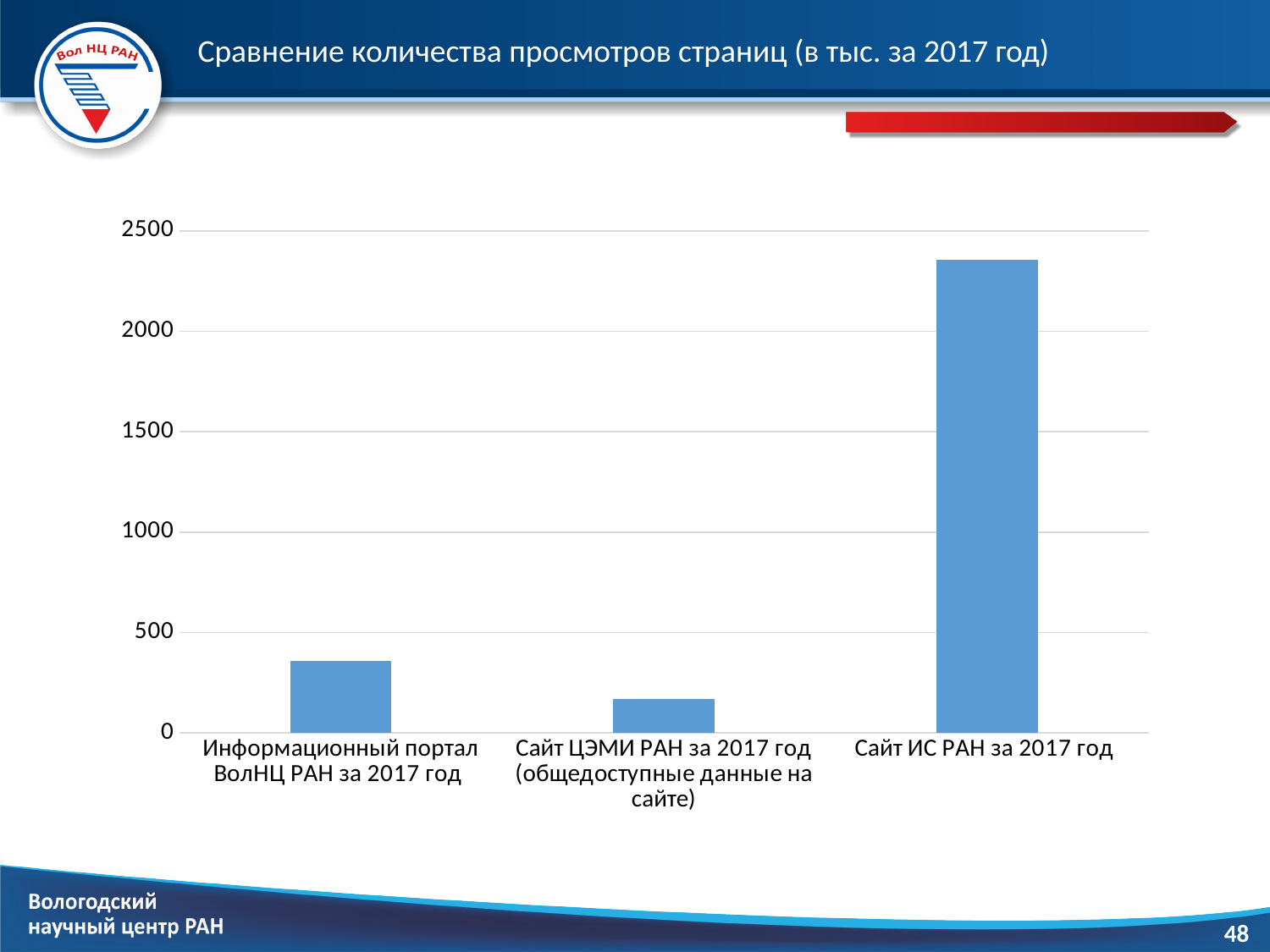
Is the value for Сайт ИС РАН за 2017 год greater or less than 2500? less Is the value for Сайт ИС РАН за 2017 год greater or less than 2000? greater Which category has the highest number of page views? Сайт ИС РАН за 2017 год How many bars (categories) does the chart show? 3 What kind of chart is shown on the slide? bar chart Is the value for Информационный портал ВолНЦ РАН за 2017 год greater or less than 500? less Which has more page views: Информационный портал ВолНЦ РАН за 2017 год or Сайт ЦЭМИ РАН за 2017 год? Информационный портал ВолНЦ РАН за 2017 год What is the highest value shown on the vertical axis? 2500 Which has more page views: Сайт ИС РАН за 2017 год or Информационный портал ВолНЦ РАН за 2017 год? Сайт ИС РАН за 2017 год What is the title of the chart on the slide? Сравнение количества просмотров страниц (в тыс. за 2017 год) Which category has the lowest number of page views? Сайт ЦЭМИ РАН за 2017 год (общедоступные данные на сайте)